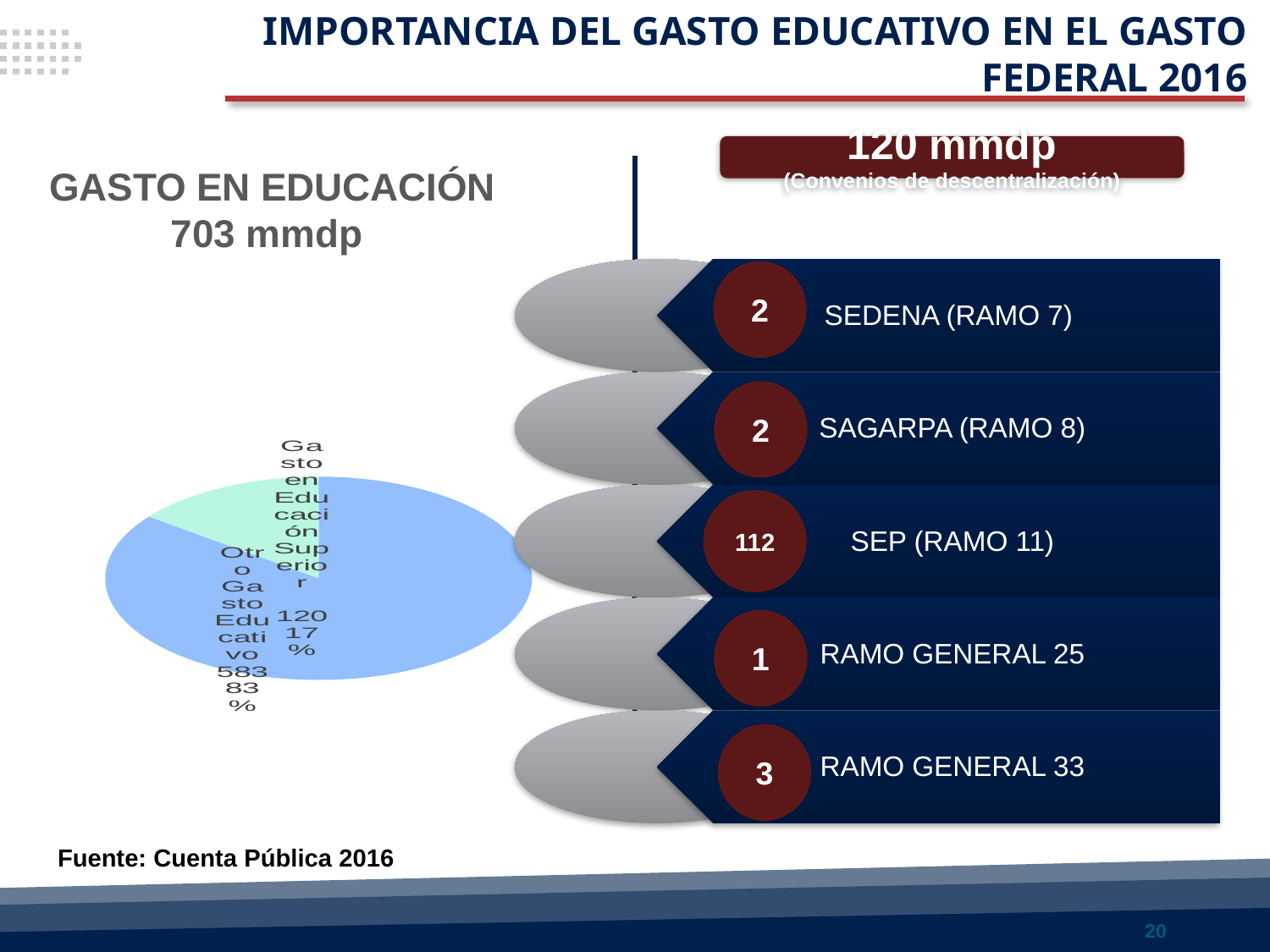
What is the total of the two values shown in the pie chart? 703 What percentage share does Gasto en Educación Superior have in the pie chart? 17% Which slice of the pie chart is the smallest? Gasto en Educación Superior What kind of chart is shown on the left of the slide? pie chart What is the difference between the values for Otro Gasto Educativo and Gasto en Educación Superior in the pie chart? 463 What value is shown for Gasto en Educación Superior in the pie chart? 120 How many slices does the pie chart have? 2 Which slice of the pie chart is the largest? Otro Gasto Educativo What value is shown for Otro Gasto Educativo in the pie chart? 583 What colour is the Otro Gasto Educativo slice in the pie chart? blue What percentage share does Otro Gasto Educativo have in the pie chart? 83% Which is larger in the pie chart, Gasto en Educación Superior or Otro Gasto Educativo? Otro Gasto Educativo